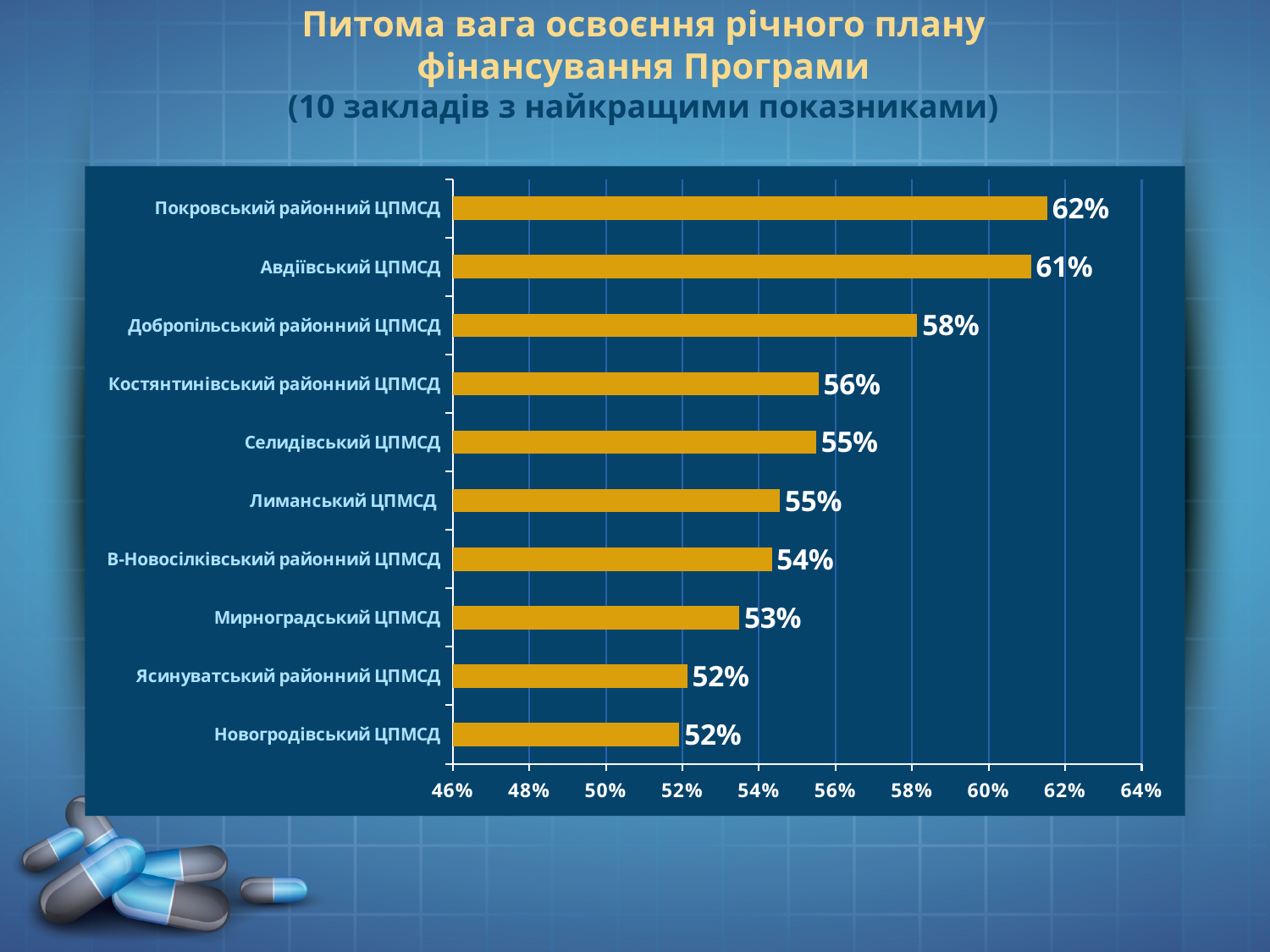
What is the difference between the values for Покровський районний ЦПМСД and Добропільський районний ЦПМСД? 4 percentage points Is the value for Мирноградський ЦПМСД greater or less than 52%? greater What is the value for Покровський районний ЦПМСД? 62% What is the value for Мирноградський ЦПМСД? 53% Which has a larger value, Авдіївський ЦПМСД or Добропільський районний ЦПМСД? Авдіївський ЦПМСД What kind of chart is shown on the slide? Bar chart How many institutions are shown on the chart? 10 What is the value for Добропільський районний ЦПМСД? 58% What is the value for Костянтинівський районний ЦПМСД? 56% What colour are the bars on the chart? Yellow (gold) Do the values increase or decrease going from the top bar to the bottom bar? Decrease Which institution has the highest value on the chart? Покровський районний ЦПМСД